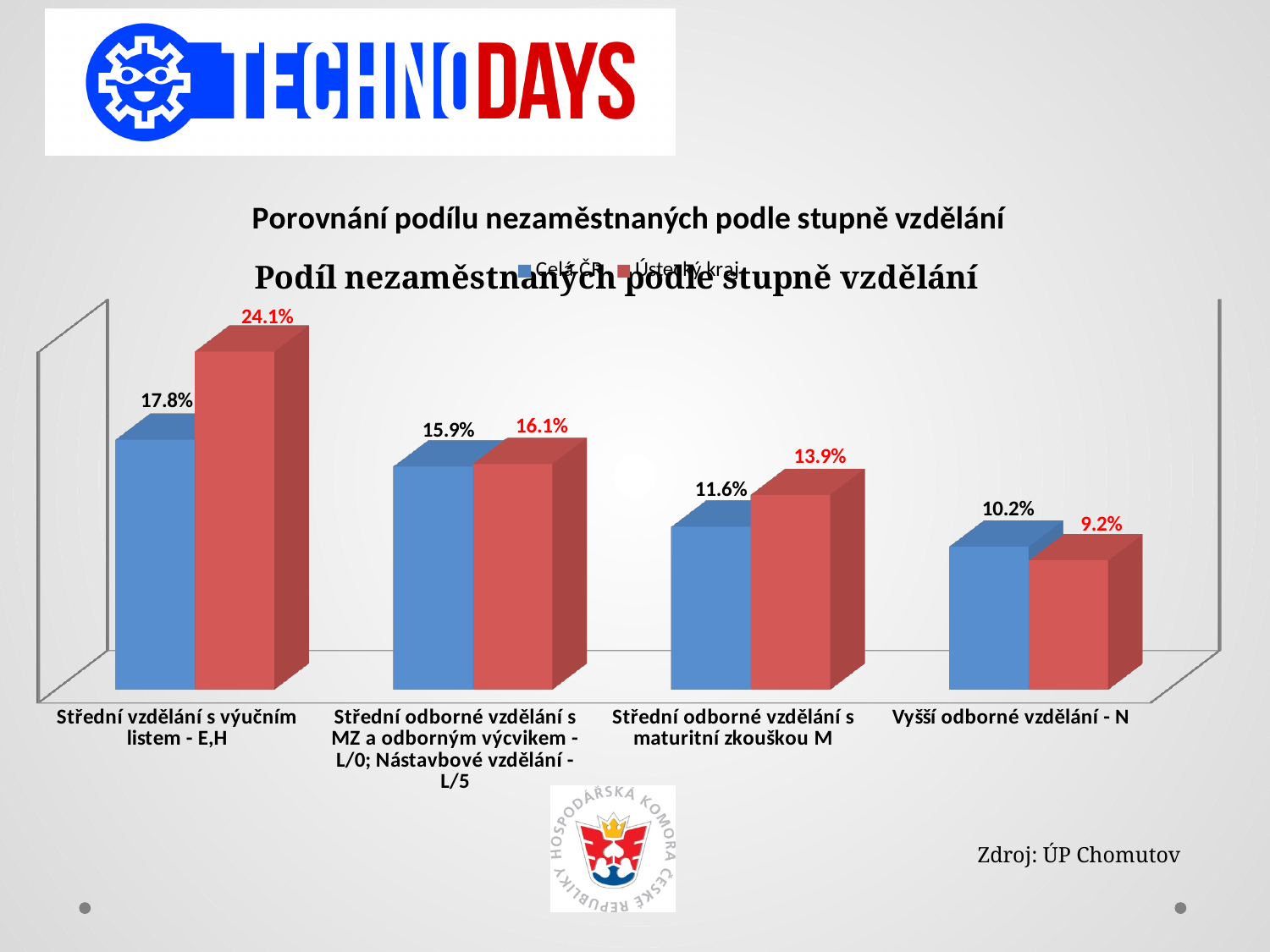
How many categories are shown on the x axis? 4 Do the blue (Celá ČR) values rise or fall from left to right across the categories? Fall What is the value of the blue (Celá ČR) bar for 'Vyšší odborné vzdělání - N'? 10.2% Which category has the highest red (Ústecký kraj) value? Střední vzdělání s výučním listem - E,H What is the difference between the red and blue bars for 'Střední vzdělání s výučním listem - E,H'? 6.3% Which category has the lowest blue (Celá ČR) value? Vyšší odborné vzdělání - N For 'Vyšší odborné vzdělání - N', which is larger: the blue (Celá ČR) bar or the red (Ústecký kraj) bar? Blue (Celá ČR) What kind of chart is shown on the slide? Bar chart What is the value of the red (Ústecký kraj) bar for 'Střední odborné vzdělání s maturitní zkouškou M'? 13.9% How many series does the chart plot? 2 What is the value of the blue (Celá ČR) bar for 'Střední odborné vzdělání s MZ a odborným výcvikem - L/0; Nástavbové vzdělání - L/5'? 15.9% What is the value of the red (Ústecký kraj) bar for 'Střední vzdělání s výučním listem - E,H'? 24.1%